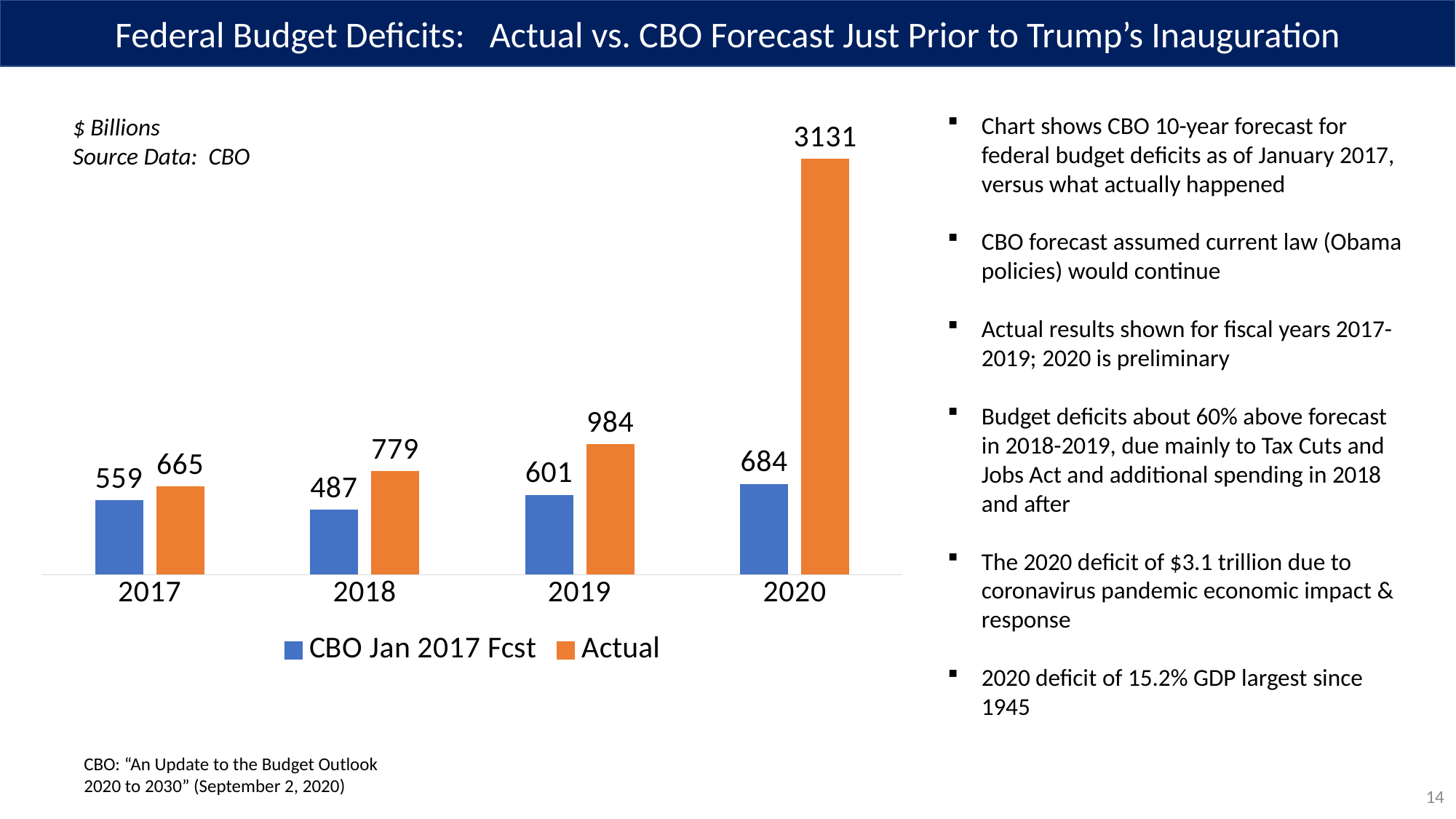
What is the difference between the Actual and CBO Jan 2017 Fcst values for 2020? 2447 Do the Actual values rise or fall from 2017 to 2020? Rise What is the Actual value for 2019? 984 What kind of chart is shown on the slide? Bar chart How many series does the legend list? 2 What is the difference between the Actual and CBO Jan 2017 Fcst values for 2018? 292 Which year has the highest Actual deficit? 2020 What is the Actual deficit value for 2020? 3131 Which is larger for 2017, the CBO Jan 2017 Fcst or the Actual value? Actual Which year has the lowest CBO Jan 2017 Fcst value? 2018 What is the CBO Jan 2017 Fcst value for 2018? 487 How many years are shown on the x axis? 4